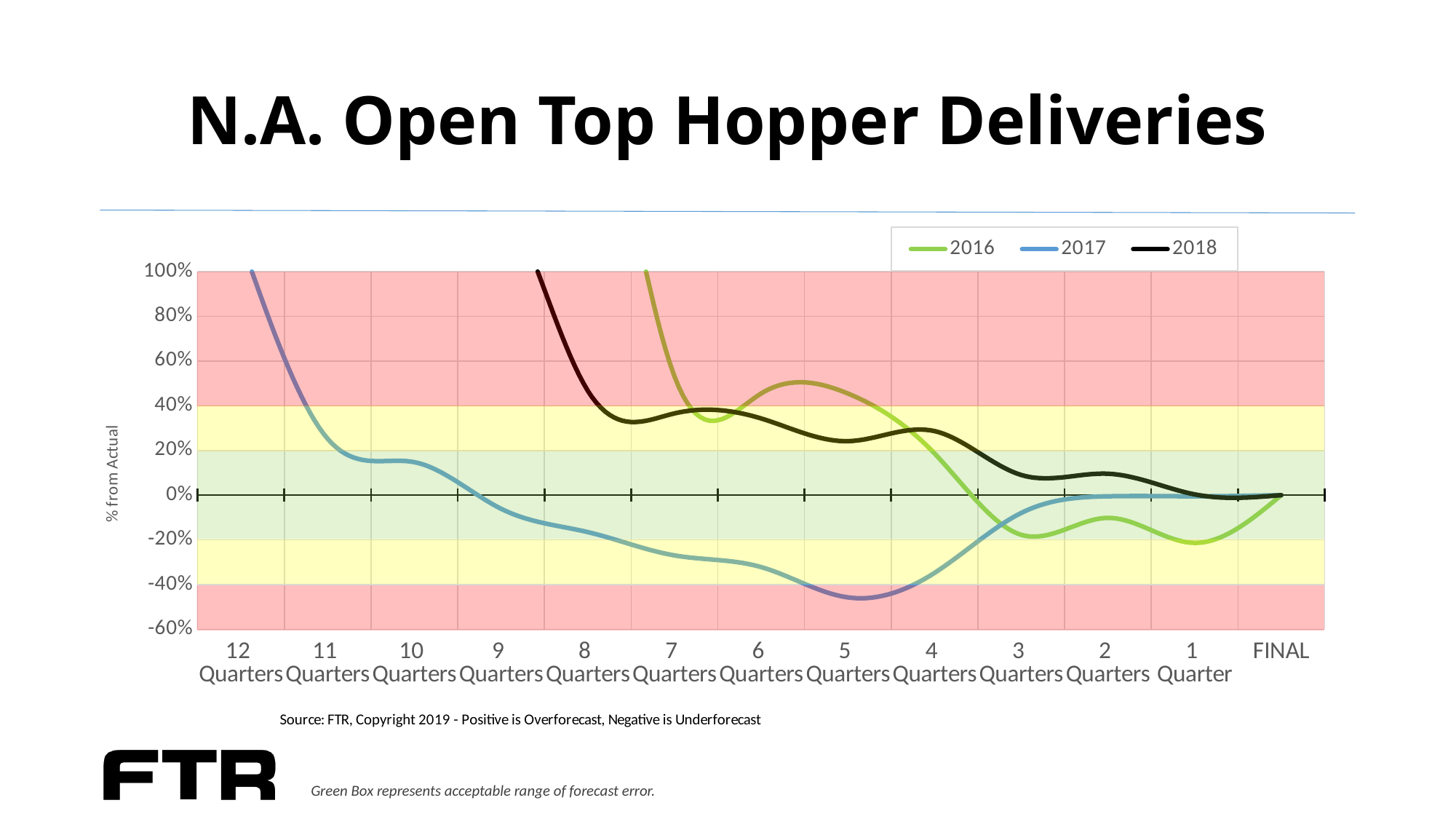
How many series does the legend list? 3 Is the value for 2016 at 6 Quarters greater or less than 40%? greater Does the 2017 series rise or fall from 12 Quarters to 5 Quarters? fall Is the value for 2017 at 5 Quarters greater or less than -40%? less What value do all three series reach at FINAL? 0% Is the value for 2018 at 3 Quarters greater or less than 20%? less What kind of chart is shown on the slide? line chart What is the title of the chart? N.A. Open Top Hopper Deliveries How many categories are shown along the x axis? 13 At 6 Quarters, which series has the higher value, 2016 or 2018? 2016 What is the label on the y axis? % from Actual